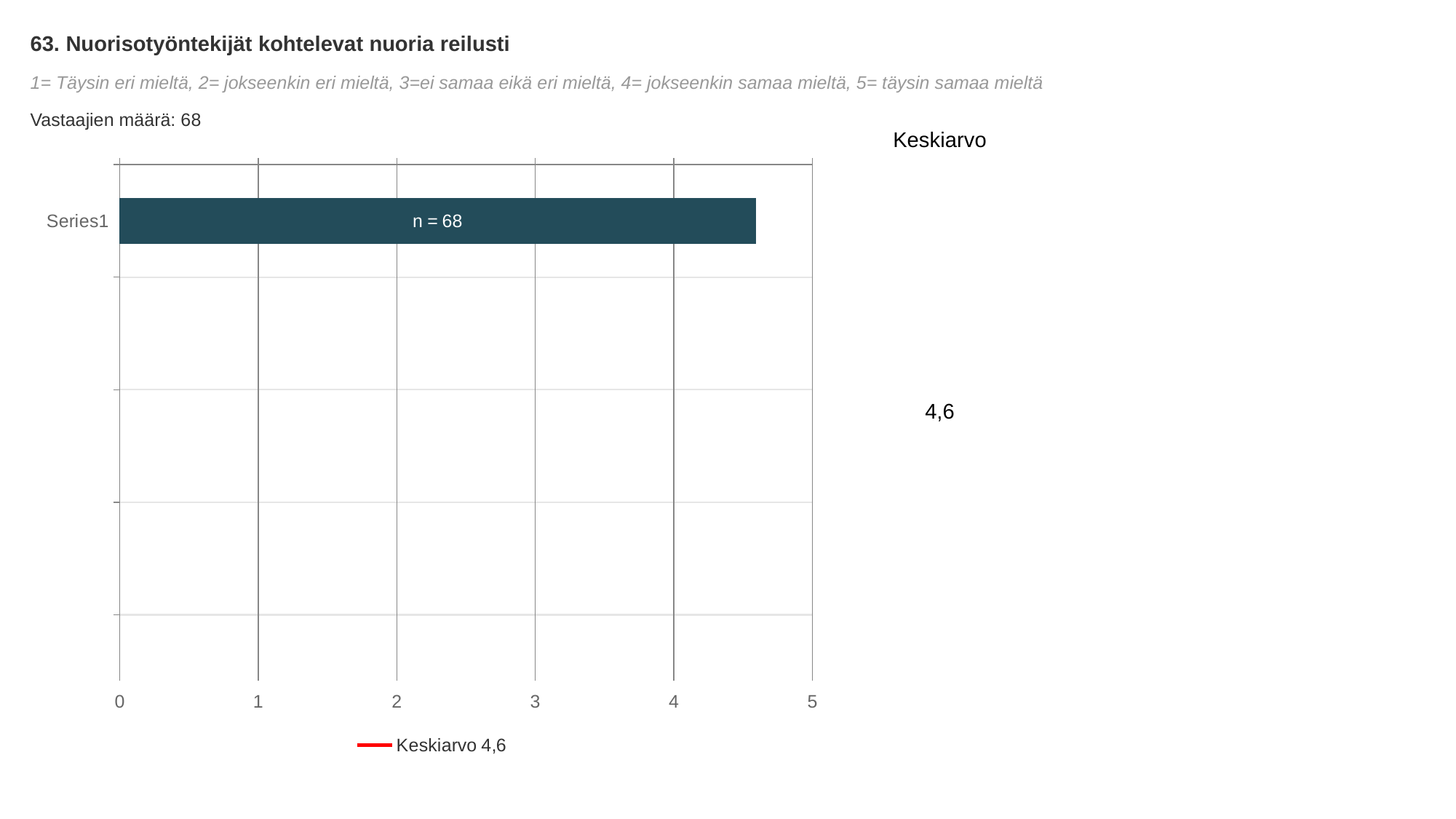
Is the value for Series1 greater or less than 4? greater How many entries does the chart legend list? 1 What is the title of the chart on the slide? 63. Nuorisotyöntekijät kohtelevat nuoria reilusti What is the Keskiarvo (mean) value shown on the slide? 4,6 How many bars does the chart contain? 1 What data label is printed on the Series1 bar? n = 68 What is the number of respondents (Vastaajien määrä) stated on the slide? 68 What is the highest value shown on the horizontal axis? 5 What kind of chart is shown on the slide? bar chart Is the value for Series1 greater or less than 5? less